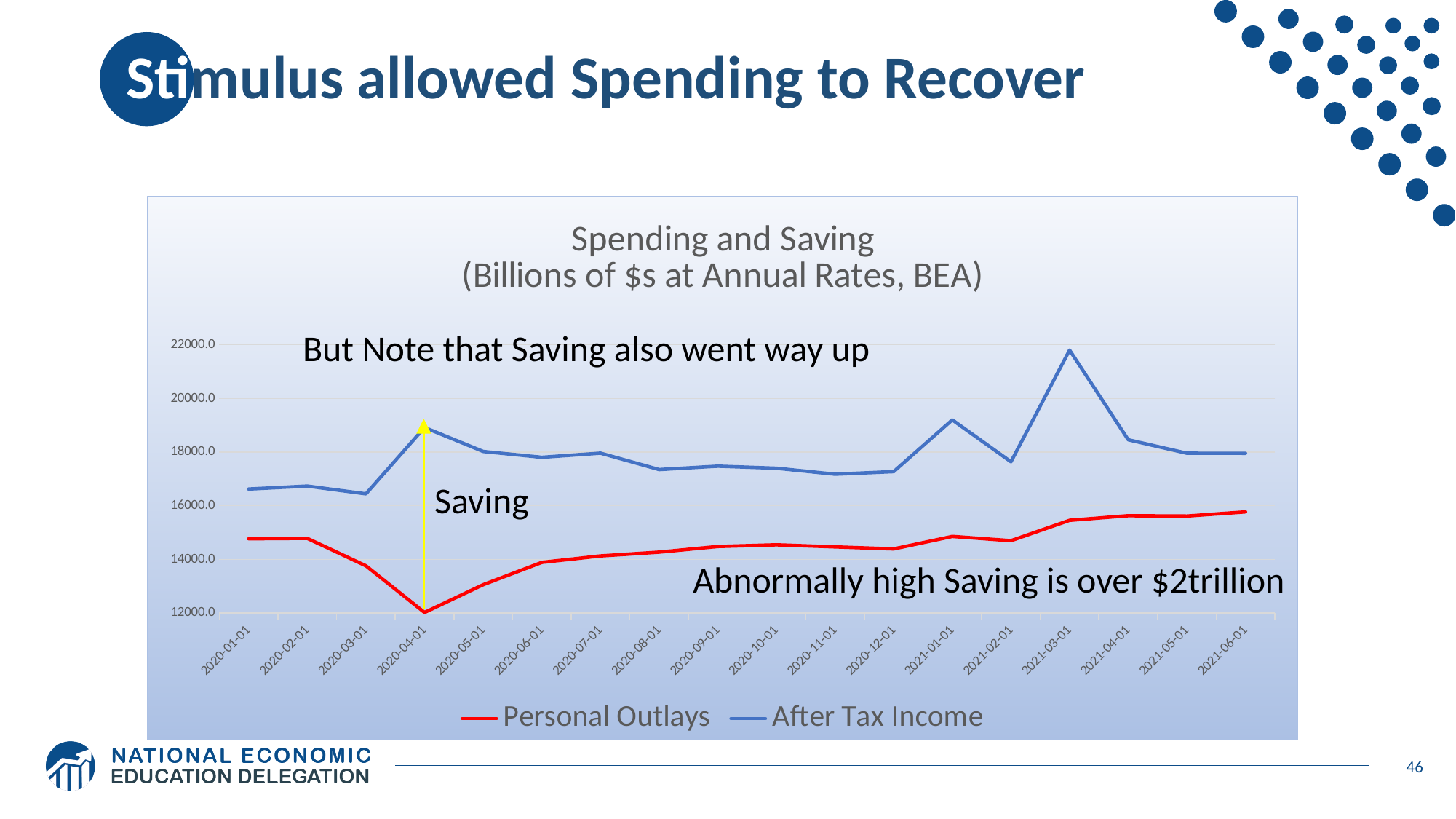
What kind of chart is shown on the slide? Line chart What is the title of the chart? Spending and Saving (Billions of $s at Annual Rates, BEA) At which date does After Tax Income reach its highest value? 2021-03-01 How many dates are plotted along the x axis of the chart? 18 At 2020-04-01, which series has the larger value, Personal Outlays or After Tax Income? After Tax Income How many series does the chart's legend list? 2 Is the value of Personal Outlays at 2020-01-01 greater or less than 16000.0? less Is the value of After Tax Income at 2021-03-01 greater or less than 20000.0? greater Which series is drawn in red in the chart? Personal Outlays Is the value of After Tax Income at 2020-04-01 greater or less than 18000.0? greater Does Personal Outlays generally rise or fall from 2020-04-01 to 2021-06-01? Rise At which date does Personal Outlays reach its lowest value? 2020-04-01